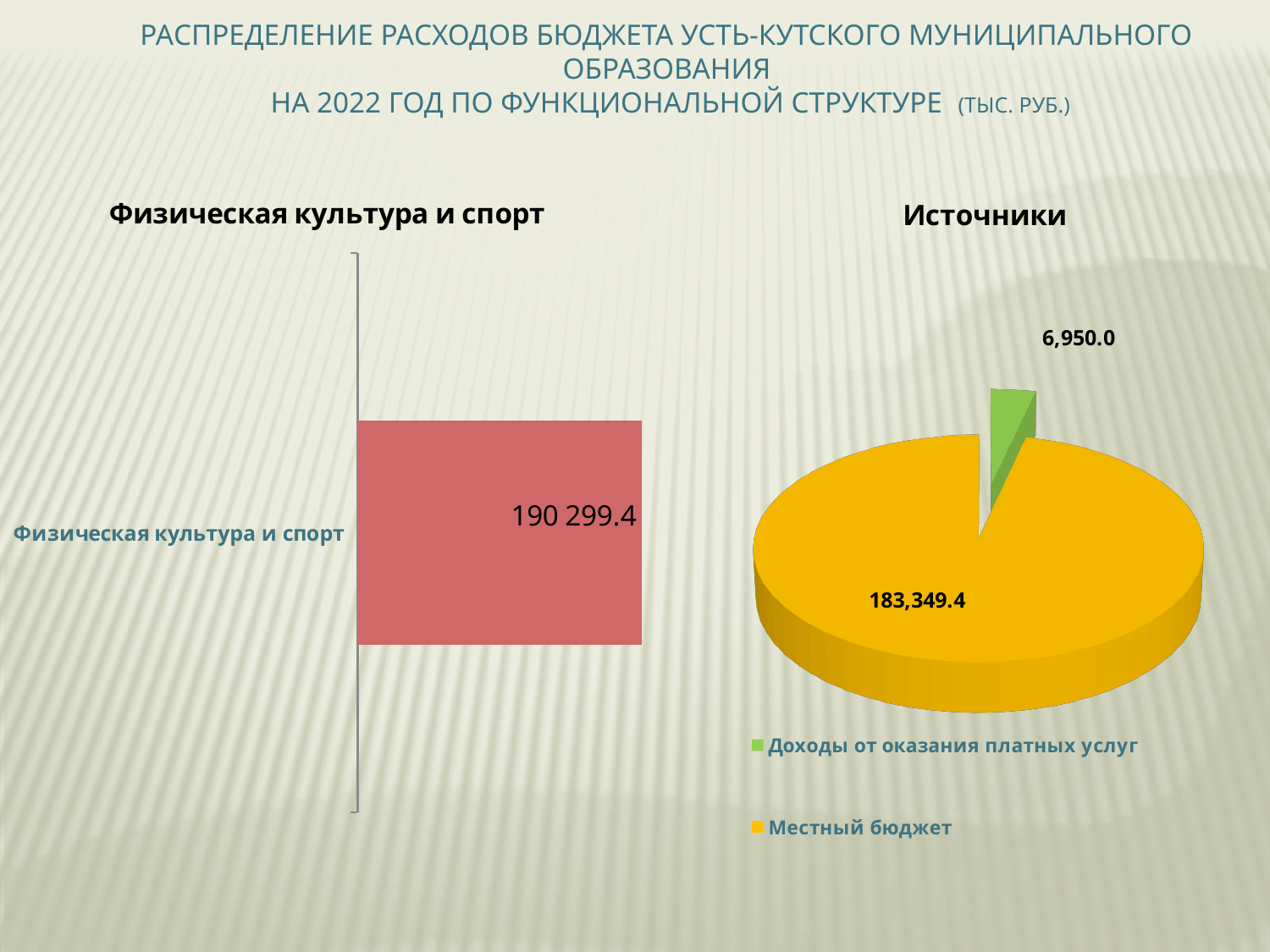
In the pie chart titled "Источники", what is the difference between the value for "Местный бюджет" and the value for "Доходы от оказания платных услуг"? 176,399.4 How many entries does the legend of the pie chart titled "Источники" list? 2 In the pie chart titled "Источники", what is the total of the two slices? 190,299.4 In the pie chart titled "Источники", which category has the smallest slice? Доходы от оказания платных услуг How many bars are plotted in the chart titled "Физическая культура и спорт"? 1 In the pie chart titled "Источники", which category has the largest slice? Местный бюджет What kind of chart is the right chart titled "Источники"? pie chart In the pie chart titled "Источники", what colour is the slice for "Местный бюджет"? yellow In the pie chart titled "Источники", what is the value for "Местный бюджет"? 183,349.4 In the bar chart titled "Физическая культура и спорт", what is the value of the bar? 190 299.4 What kind of chart is the left chart titled "Физическая культура и спорт"? bar chart In the pie chart titled "Источники", what is the value for "Доходы от оказания платных услуг"? 6,950.0